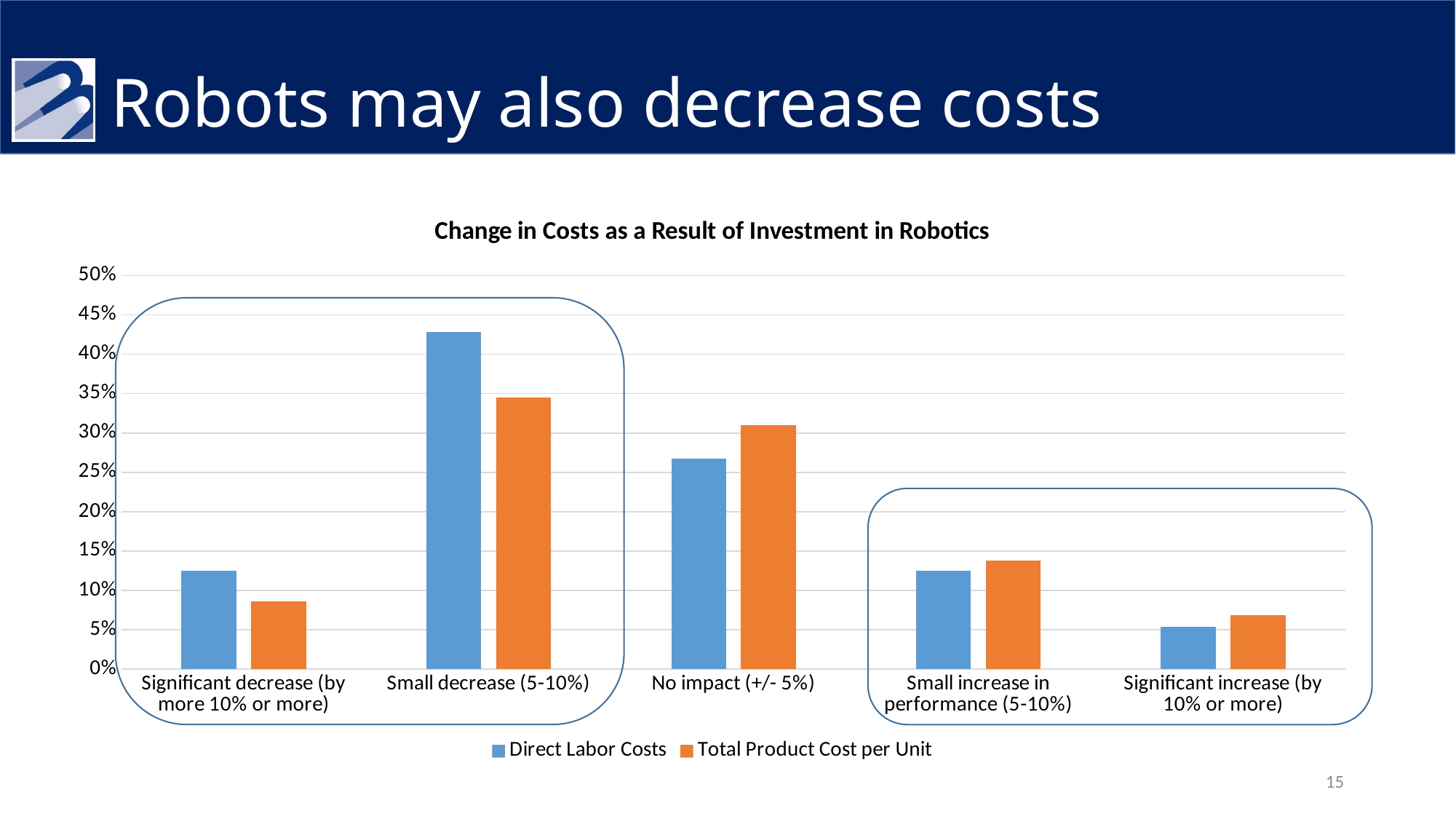
Which category has the lowest value for Direct Labor Costs? Significant increase (by 10% or more) What type of chart is shown on the slide? Bar chart For the No impact (+/- 5%) category, which series has the larger value: Direct Labor Costs or Total Product Cost per Unit? Total Product Cost per Unit Is the Direct Labor Costs value for Significant increase (by 10% or more) greater or less than 10%? less Which category has the highest value for Total Product Cost per Unit? Small decrease (5-10%) For the Small decrease (5-10%) category, which series has the larger value: Direct Labor Costs or Total Product Cost per Unit? Direct Labor Costs Which category has the lowest value for Total Product Cost per Unit? Significant increase (by 10% or more) How many series does the legend list? 2 How many categories are shown on the x axis? 5 Is the Direct Labor Costs value for Small decrease (5-10%) greater or less than 40%? greater What is the title of the chart? Change in Costs as a Result of Investment in Robotics Which category has the highest value for Direct Labor Costs? Small decrease (5-10%)